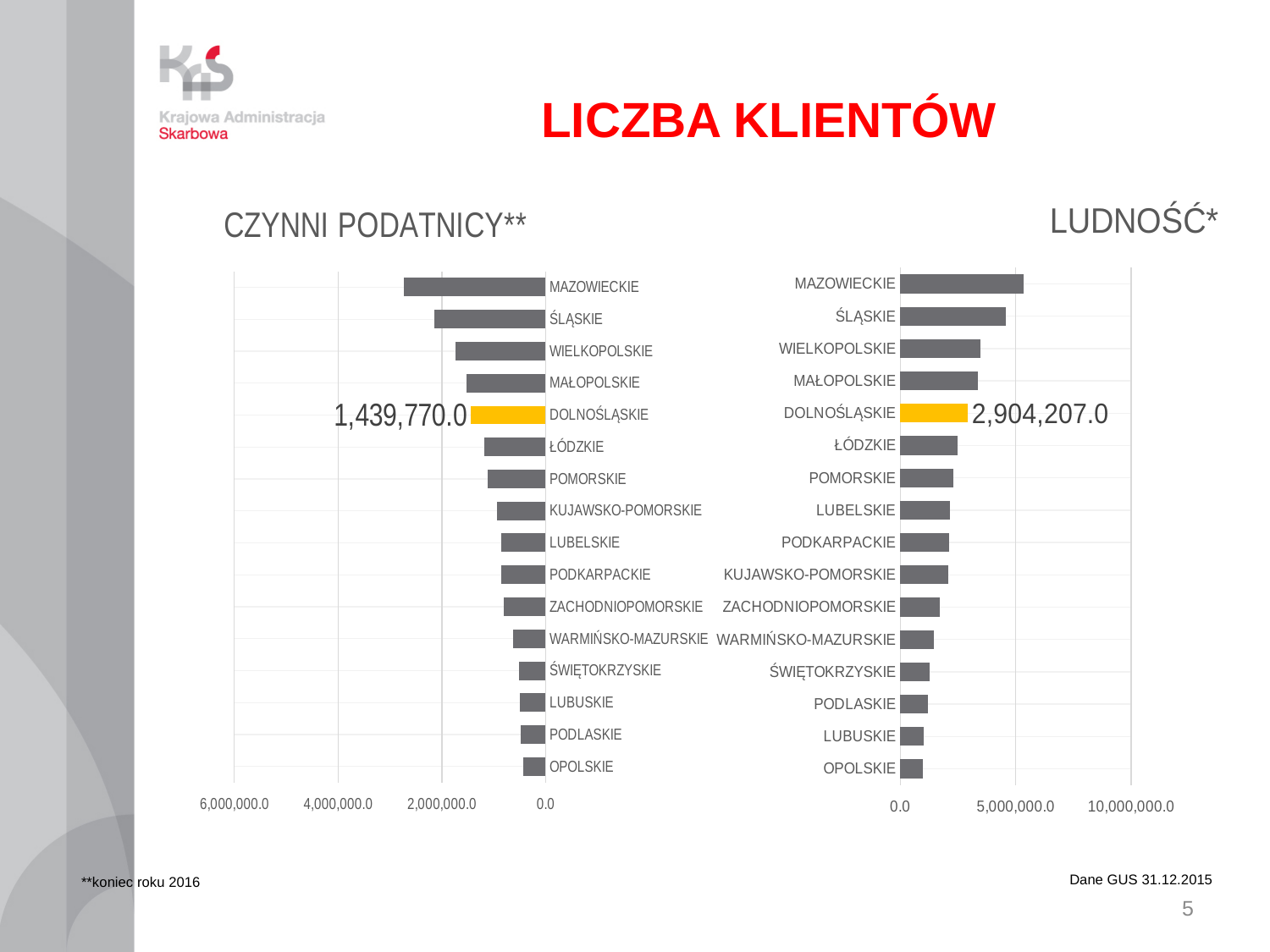
In the LUDNOŚĆ* chart, what value is labelled for DOLNOŚLĄSKIE? 2,904,207.0 In the LUDNOŚĆ* chart, which region has the highest value? MAZOWIECKIE In the CZYNNI PODATNICY** chart, is the value for WIELKOPOLSKIE greater or less than 2,000,000.0? less In the LUDNOŚĆ* chart, which region's bar is highlighted in yellow? DOLNOŚLĄSKIE In the CZYNNI PODATNICY** chart, is the value for MAZOWIECKIE greater or less than 2,000,000.0? greater What kind of chart is the CZYNNI PODATNICY** chart? Bar chart In the LUDNOŚĆ* chart, is the value for OPOLSKIE greater or less than 5,000,000.0? less In the LUDNOŚĆ* chart, which is larger, the value for MAZOWIECKIE or the value for OPOLSKIE? MAZOWIECKIE In the CZYNNI PODATNICY** chart, which region has the highest value? MAZOWIECKIE In the CZYNNI PODATNICY** chart, which region has the lowest value? OPOLSKIE How many regions are shown in the LUDNOŚĆ* chart? 16 In the CZYNNI PODATNICY** chart, what value is labelled for DOLNOŚLĄSKIE? 1,439,770.0